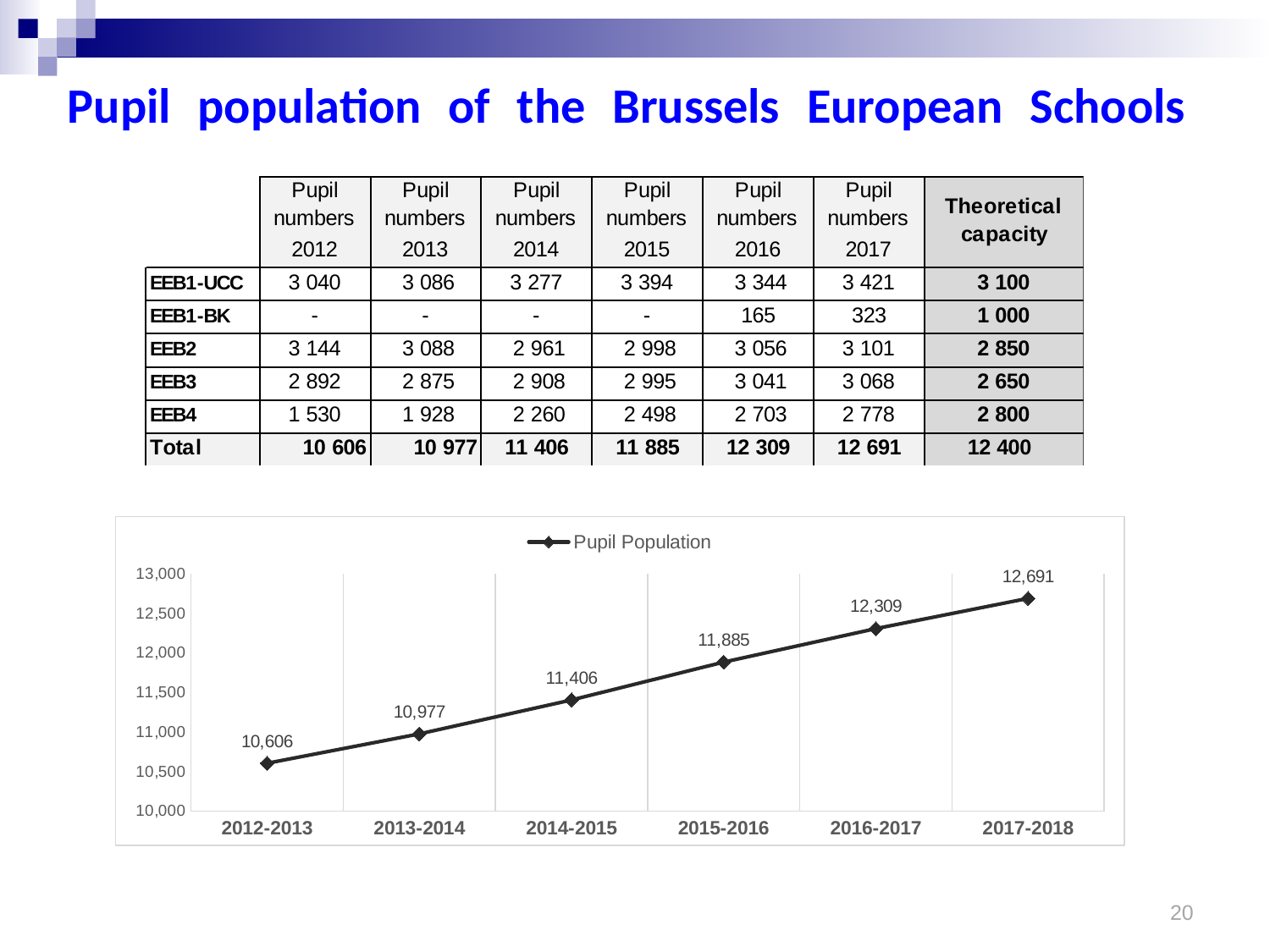
Which school year has the lowest pupil population? 2012-2013 Is the pupil population for 2015-2016 greater or less than 12,000? less What is the pupil population for 2017-2018? 12,691 What is the difference in pupil population between 2017-2018 and 2012-2013? 2,085 What is the pupil population for 2012-2013? 10,606 Which is larger, the pupil population in 2013-2014 or in 2016-2017? 2016-2017 What kind of chart is shown on the slide? line chart What is the difference in pupil population between 2015-2016 and 2014-2015? 479 Does the pupil population rise or fall from 2012-2013 to 2017-2018? rise Which school year has the highest pupil population? 2017-2018 What is the pupil population for 2014-2015? 11,406 How many school years are plotted on the chart? 6